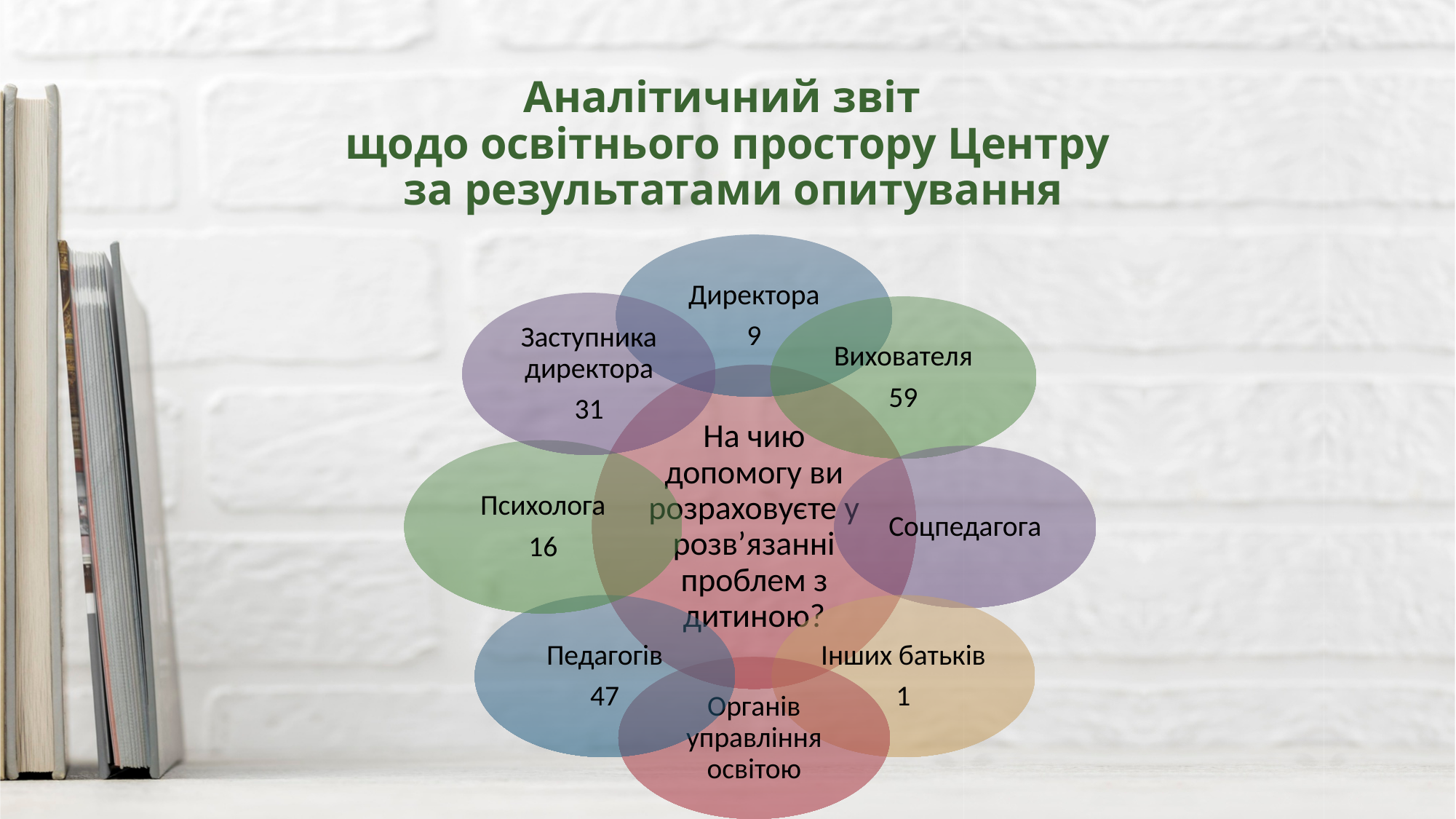
What value is shown for "Вихователя" in the diagram? 59 Which is larger, the value for "Заступника директора" or the value for "Психолога"? Заступника директора What value is shown for "Заступника директора" in the diagram? 31 What is the difference between the values for "Вихователя" and "Педагогів"? 12 What value is shown for "Директора" in the diagram? 9 What value is shown for "Педагогів" in the diagram? 47 Which category has the lowest printed value in the diagram? Інших батьків What value is shown for "Психолога" in the diagram? 16 What value is shown for "Інших батьків" in the diagram? 1 How many categories (ellipses) are shown in the diagram? 8 What question is written in the centre of the diagram? На чию допомогу ви розраховуєте у розв’язанні проблем з дитиною? Which category has the highest value in the diagram? Вихователя